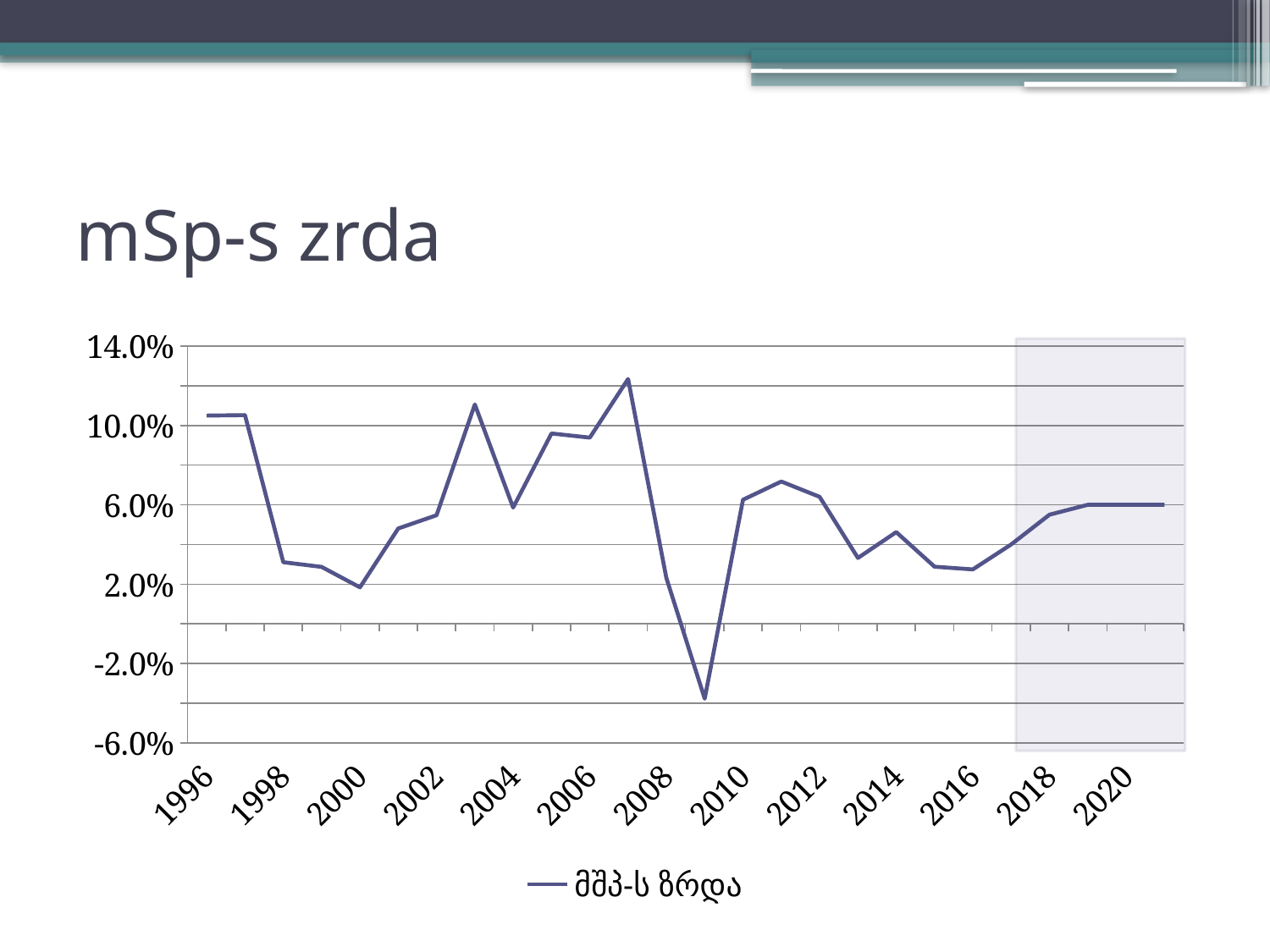
How many series does the legend list? 1 Is the value for 2016 greater or less than 6.0%? less What kind of chart is shown on the slide? line chart What is the title of the chart? mSp-s zrda Is the value for 2003 greater or less than 10.0%? greater Does the line rise or fall between 2016 and 2020? rise Is the value for 2011 greater or less than 6.0%? greater In which year does the line reach its highest value? 2007 In which year does the line reach its lowest value? 2009 Does the line rise or fall between 2007 and 2009? fall Which year has the larger value, 2007 or 2003? 2007